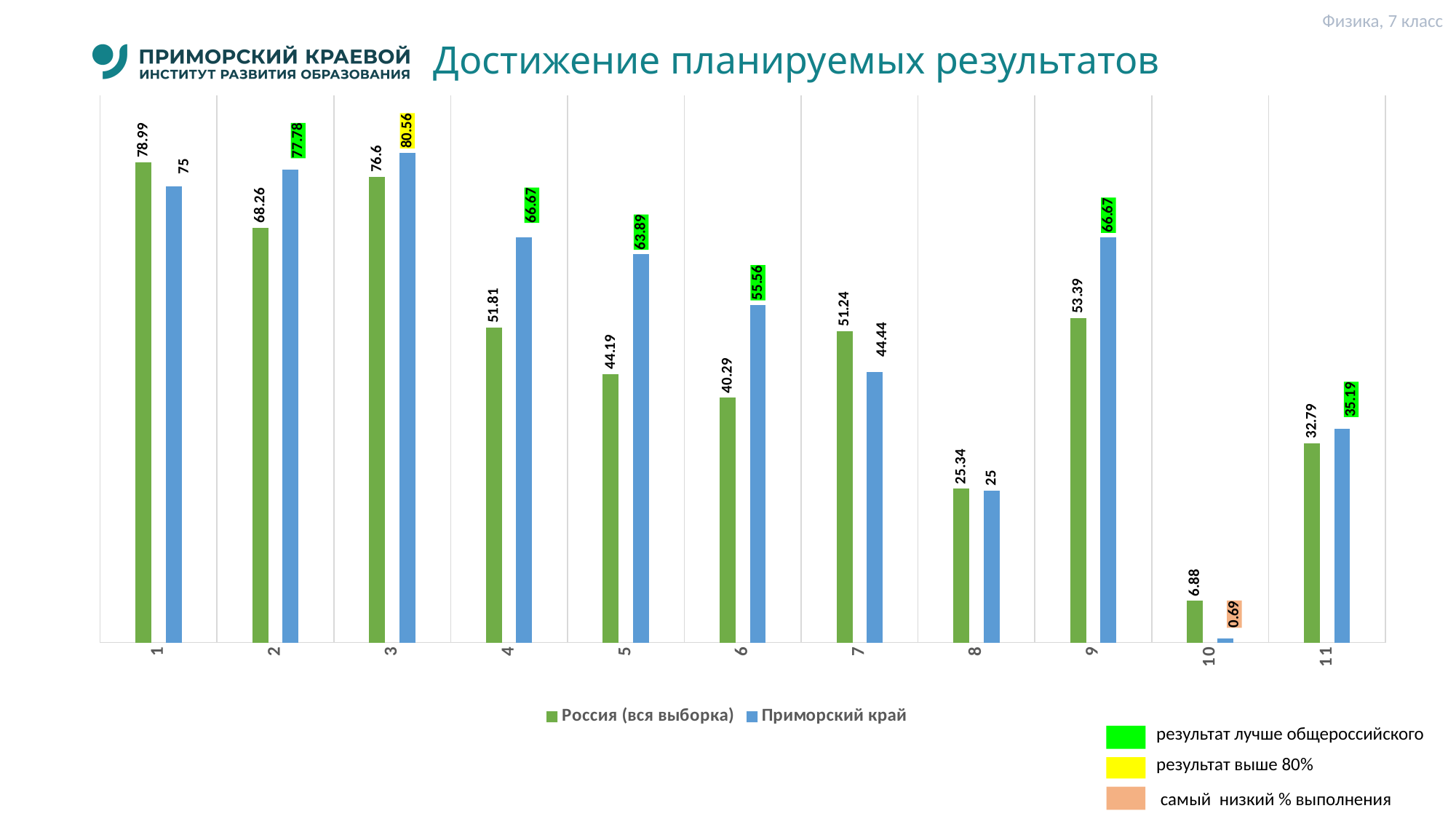
What is the value for Приморский край for category 3? 80.56 Which category has the lowest value for Приморский край? 10 How many series does the legend list? 2 How many categories are shown on the x axis? 11 Which colour represents the series Приморский край in the chart? blue What is the value for Приморский край for category 10? 0.69 What is the value for Россия (вся выборка) for category 5? 44.19 For category 7, which series has the larger value: Россия (вся выборка) or Приморский край? Россия (вся выборка) Which category has the highest value for Россия (вся выборка)? 1 What is the value for Россия (вся выборка) for category 11? 32.79 What kind of chart is shown on the slide? bar chart What is the difference between the Приморский край and Россия (вся выборка) values for category 4? 14.86